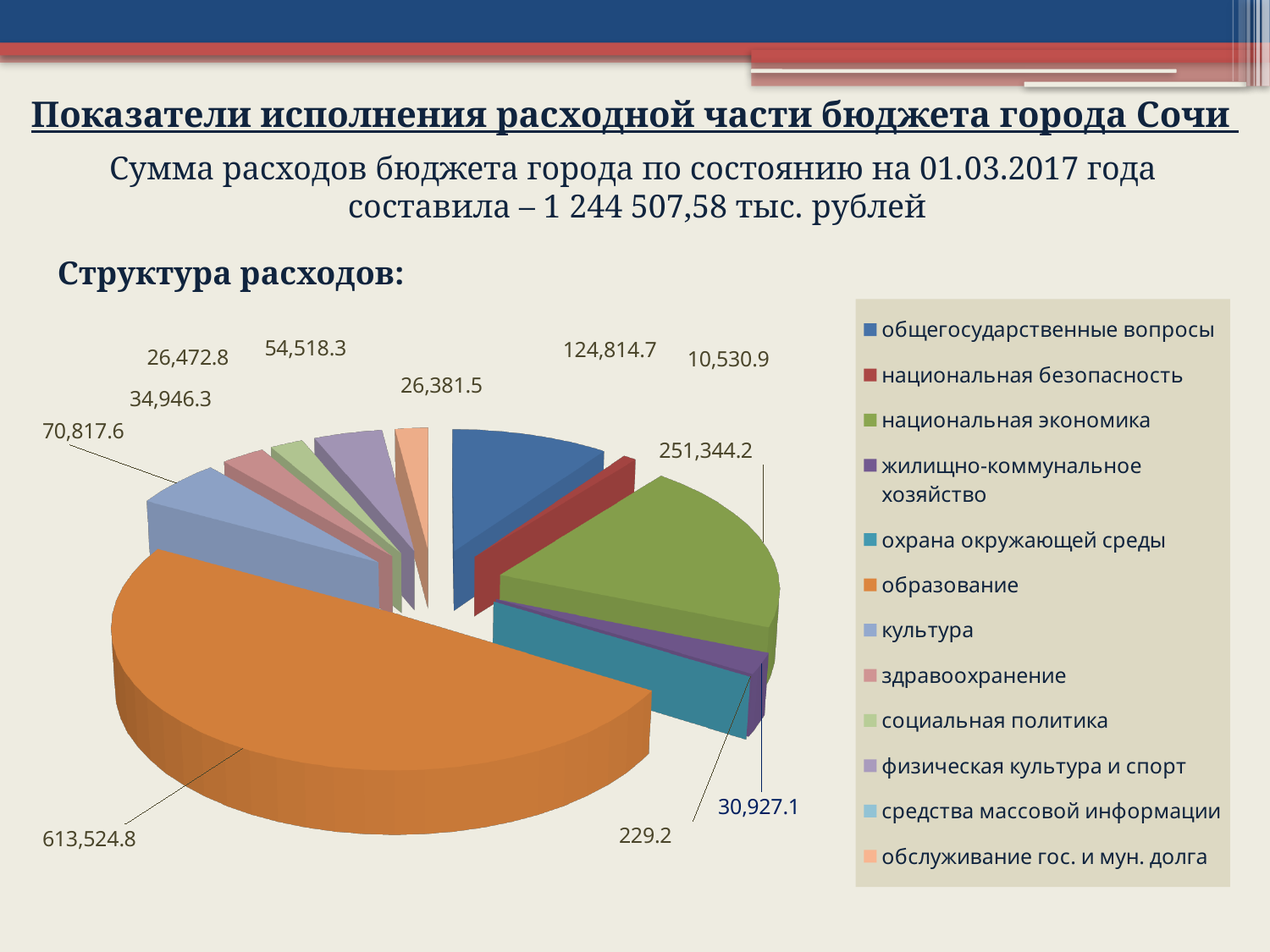
What is the value for образование in the pie chart? 613,524.8 How many categories does the legend of the pie chart list? 12 What type of chart is shown on the slide? pie chart What colour is the образование slice in the pie chart? orange Which category has the largest slice in the pie chart? образование What is the value for общегосударственные вопросы in the pie chart? 124,814.7 What is the smallest value labelled on the pie chart? 229.2 What is the difference between the values for образование and национальная экономика? 362,180.6 What is the value for культура in the pie chart? 70,817.6 What is the value for национальная безопасность in the pie chart? 10,530.9 Which is larger: национальная экономика or общегосударственные вопросы? национальная экономика What is the value for национальная экономика in the pie chart? 251,344.2